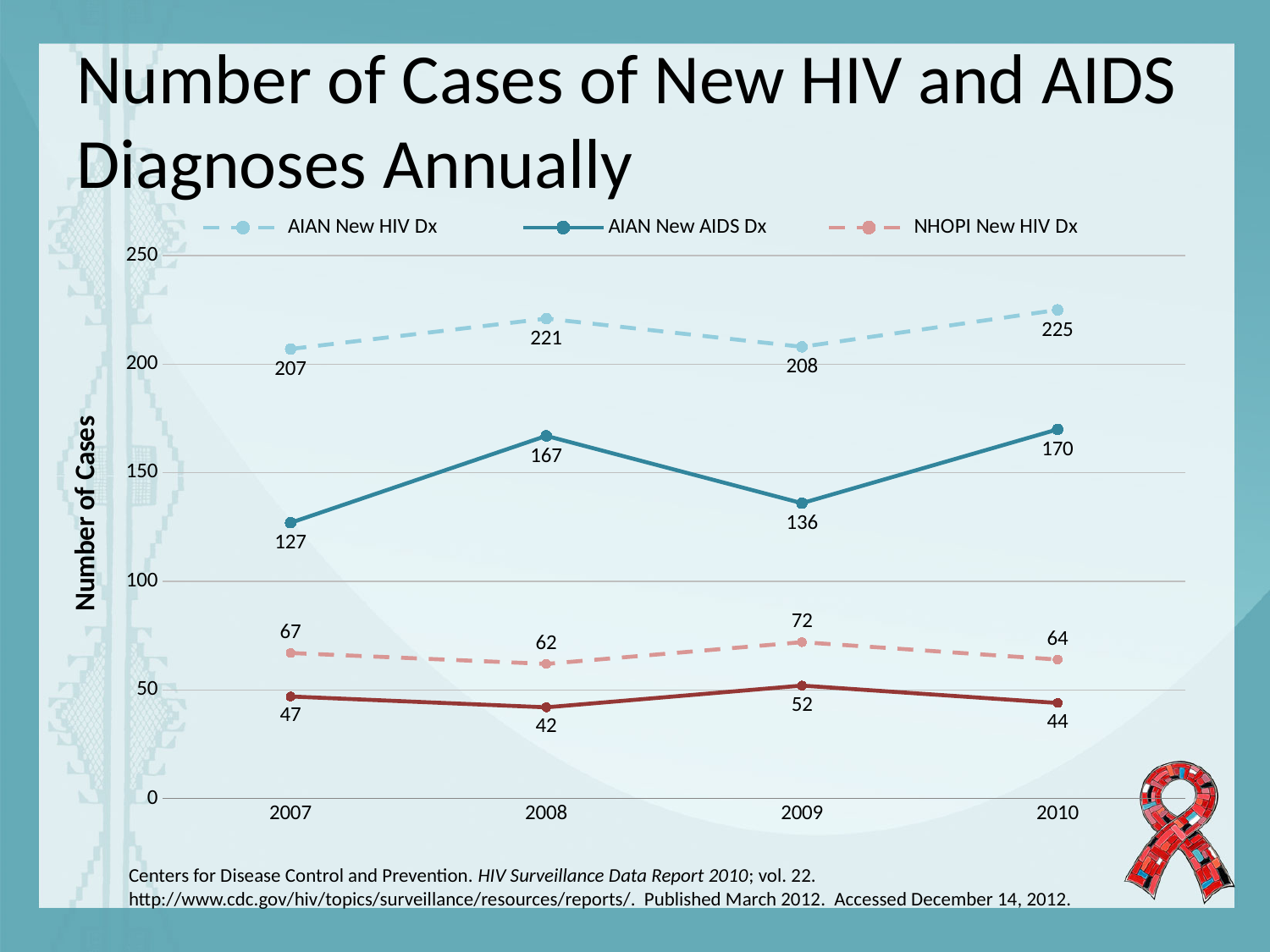
In which year was AIAN New HIV Dx highest? 2010 What type of chart is shown on the slide? line chart How many series does the legend list? 3 What is the difference between AIAN New AIDS Dx in 2010 and in 2007? 43 What is the value for AIAN New HIV Dx in 2008? 221 In which year was AIAN New AIDS Dx lowest? 2007 How many years are shown on the x axis? 4 What is the value for AIAN New AIDS Dx in 2009? 136 Which is larger: NHOPI New HIV Dx in 2009 or in 2008? 2009 Is the value for AIAN New AIDS Dx in 2008 greater or less than 150? greater What is the label on the y axis? Number of Cases What is the value for NHOPI New HIV Dx in 2010? 64